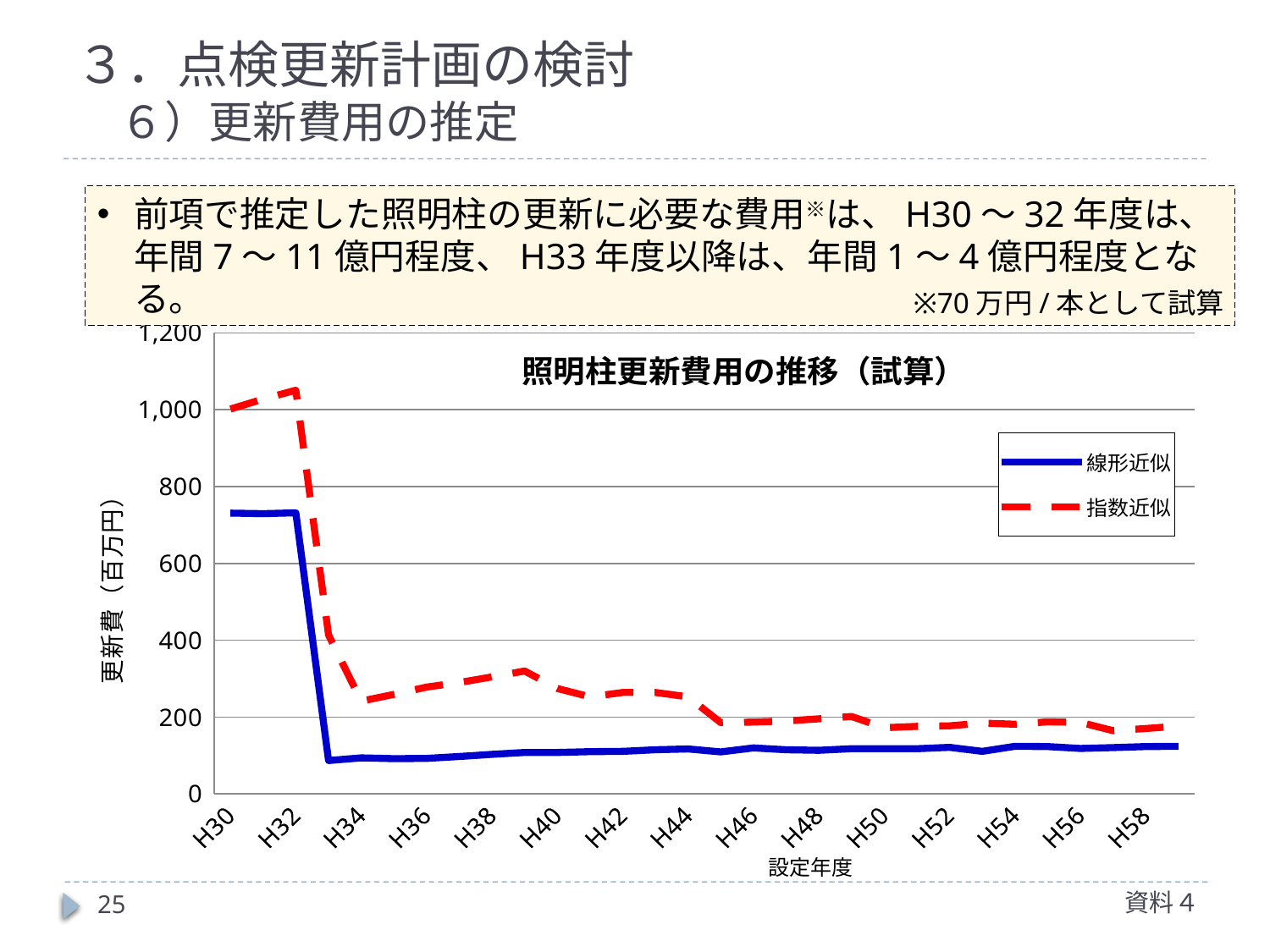
Is the value of 線形近似 at H30 greater or less than 600? greater Is the value of 線形近似 at H34 greater or less than 200? less What kind of chart is shown on the slide? line chart Which series reaches the higher peak value on the chart? 指数近似 Do the values of 線形近似 generally rise or fall from H30 to H58? fall How many series does the chart legend list? 2 Is the value of 指数近似 at H30 greater or less than 800? greater At H30, which series has the higher value, 線形近似 or 指数近似? 指数近似 Which series is drawn as a red dashed line? 指数近似 What is the title of the chart? 照明柱更新費用の推移（試算）